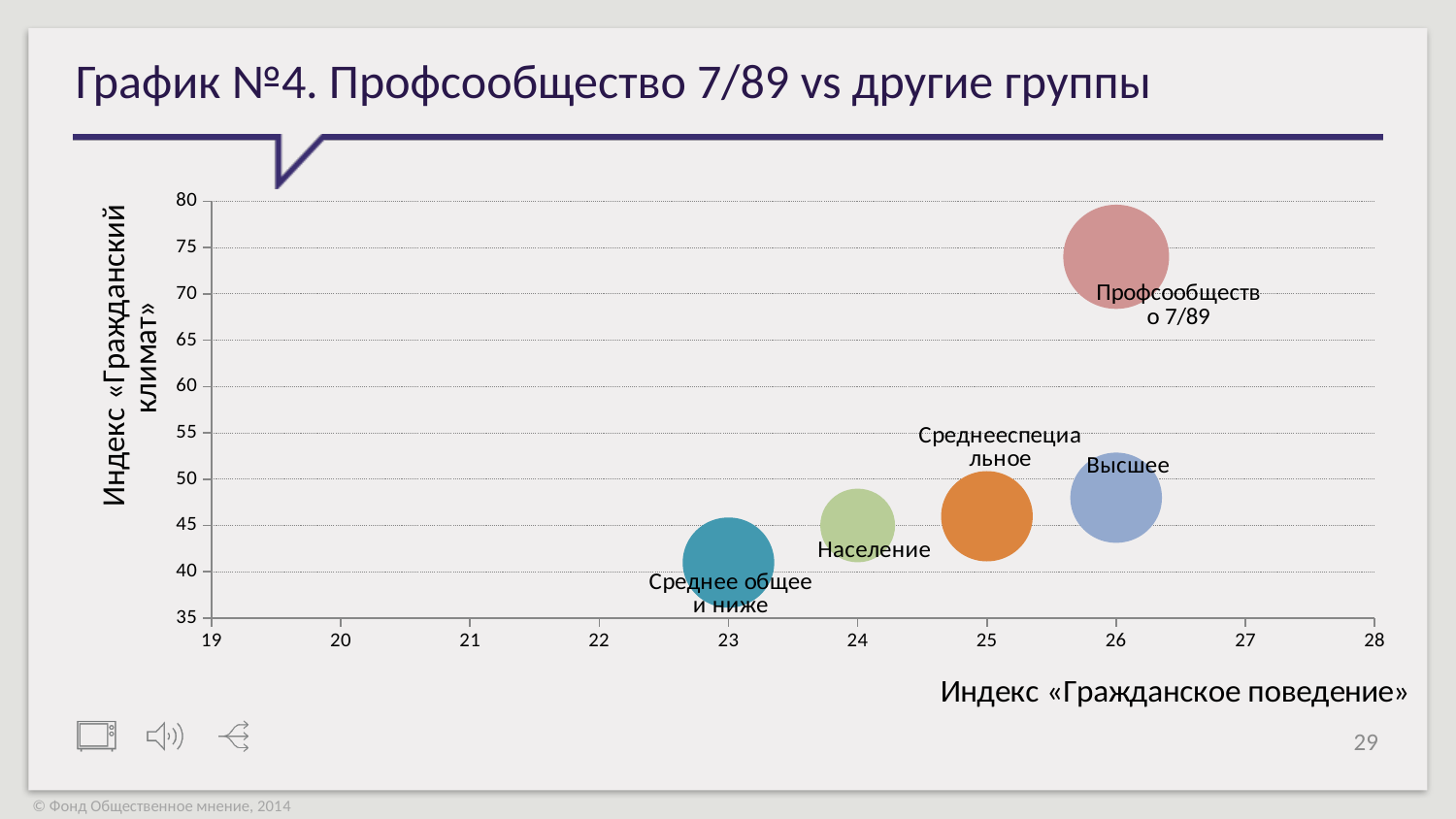
Which group has the highest value on the «Гражданский климат» index (vertical axis)? Профсообщество 7/89 What is the title of the horizontal axis of the chart? Индекс «Гражданское поведение» Do the «Гражданский климат» index values generally rise or fall as the «Гражданское поведение» index increases along the x axis? rise Which group has the lowest value on the «Гражданский климат» index (vertical axis)? Среднее общее и ниже Is the «Гражданский климат» index value for Среднее общее и ниже greater or less than 45? less What kind of chart is shown on the slide? bubble chart Which group has a higher «Гражданский климат» index: Население or Профсообщество 7/89? Профсообщество 7/89 What is the «Гражданское поведение» index (horizontal axis) value for Среднее общее и ниже? 23 Is the «Гражданский климат» index value for Профсообщество 7/89 greater or less than 70? greater What is the «Гражданское поведение» index (horizontal axis) value for Население? 24 Is the «Гражданский климат» index value for Высшее greater or less than 50? less How many groups (bubbles) are plotted on the chart? 5